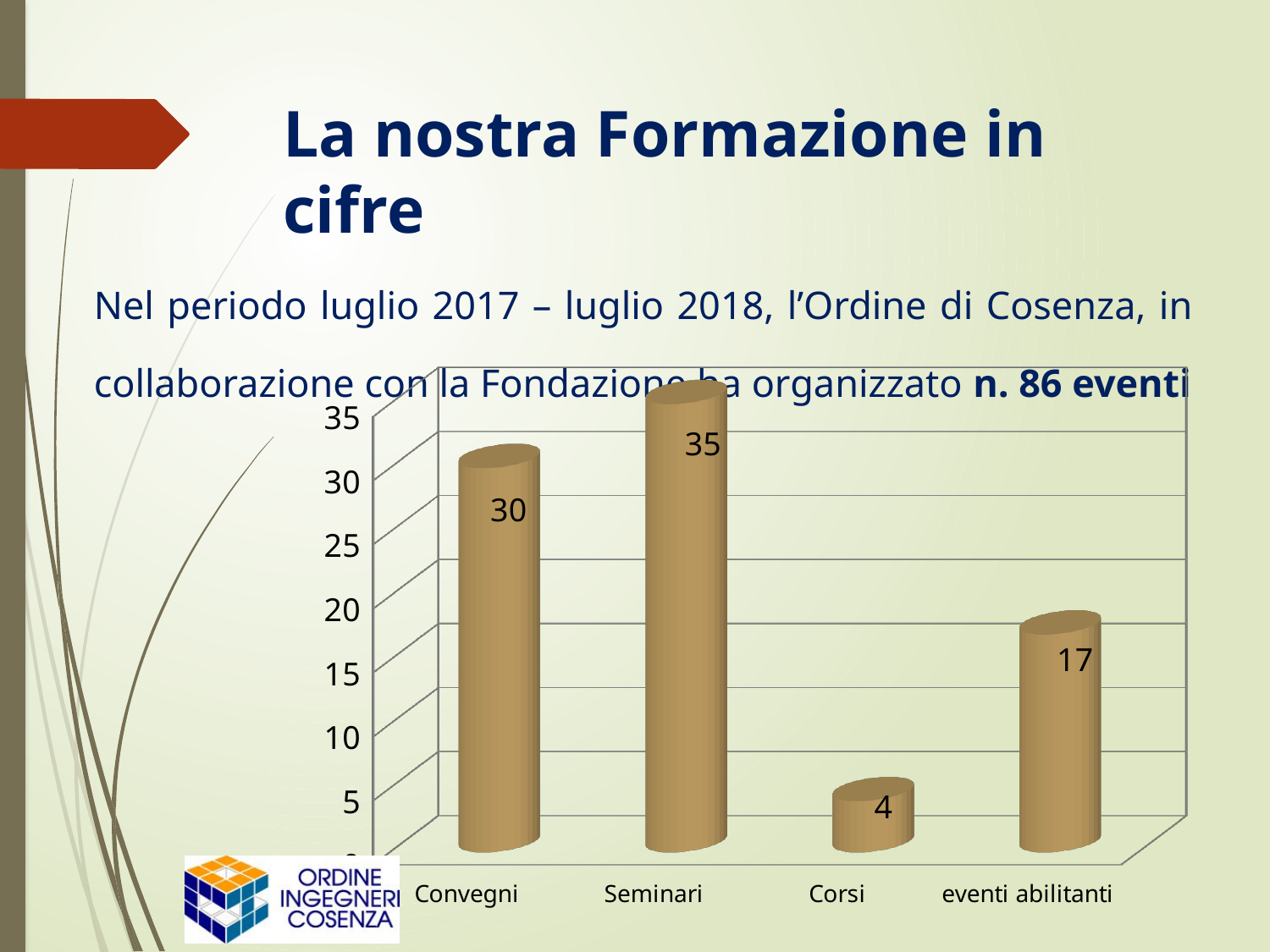
What is the value for eventi abilitanti? 17 What is the difference between the values for Convegni and eventi abilitanti? 13 Which category has the lowest value? Corsi What is the total of all four values shown on the chart? 86 How many categories are shown on the chart? 4 Which category has the highest value? Seminari What is the value for Convegni? 30 Which is larger, the value for eventi abilitanti or the value for Corsi? eventi abilitanti What kind of chart is shown on the slide? bar chart What is the difference between the values for Seminari and Convegni? 5 What is the value for Corsi? 4 What is the value for Seminari? 35